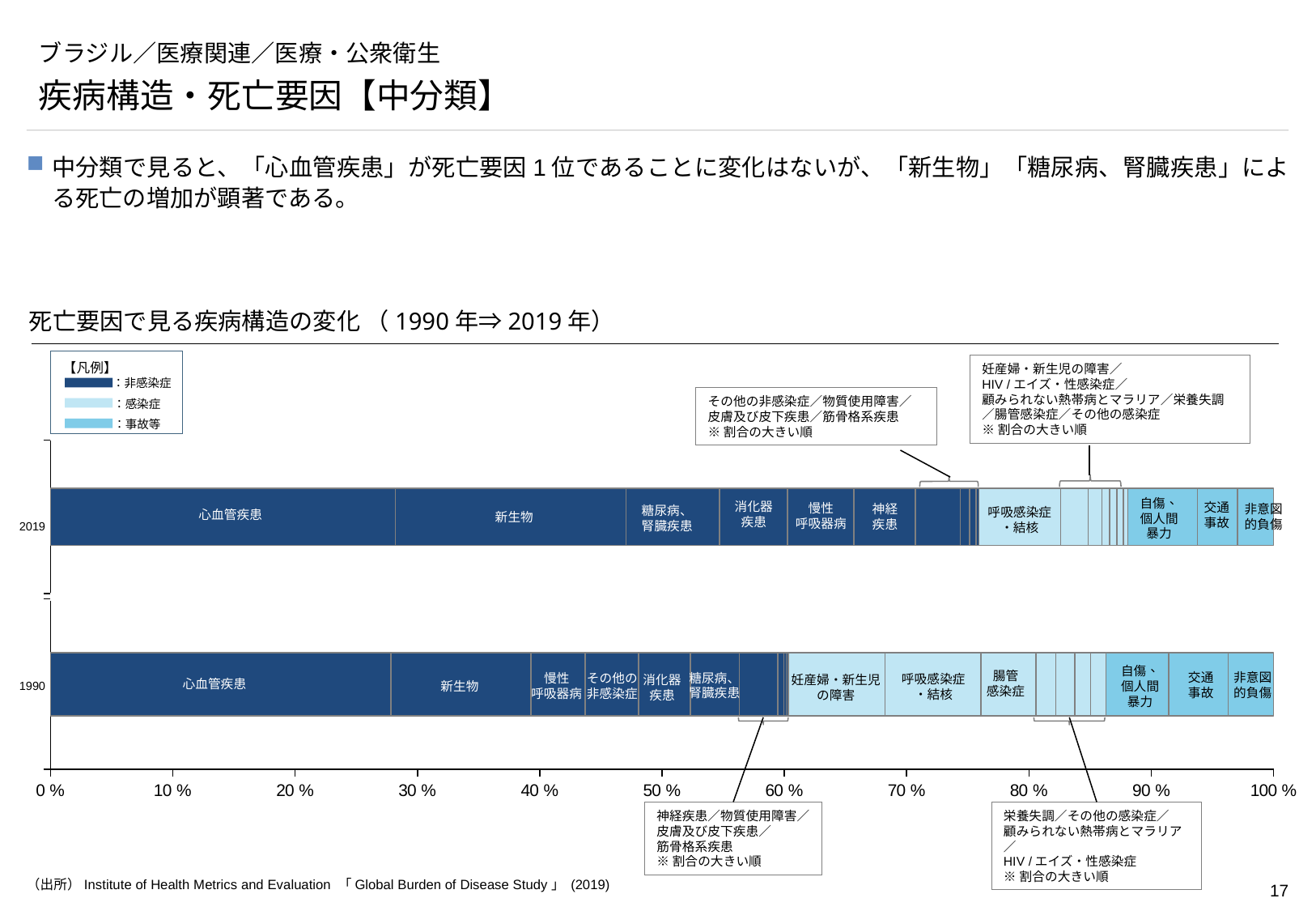
Which cause of death has the largest share in the 2019 bar? 心血管疾患 Is the share of 妊産婦・新生児の障害 larger in 1990 or in 2019? 1990 Which legend category is shown in the darkest blue? 非感染症 Is the share of 心血管疾患 in 2019 greater or less than 20%? greater What kind of chart is shown on the slide? Stacked bar chart How many bars (years) does the chart show? 2 Is the share of 新生物 larger in 2019 or in 1990? 2019 What is the title of the chart? 死亡要因で見る疾病構造の変化（1990年⇒2019年） Is the share of 新生物 in 2019 greater or less than 10%? greater Which cause of death has the largest share in the 1990 bar? 心血管疾患 Is the share of 新生物 in 1990 greater or less than 20%? less How many categories does the legend (凡例) list? 3